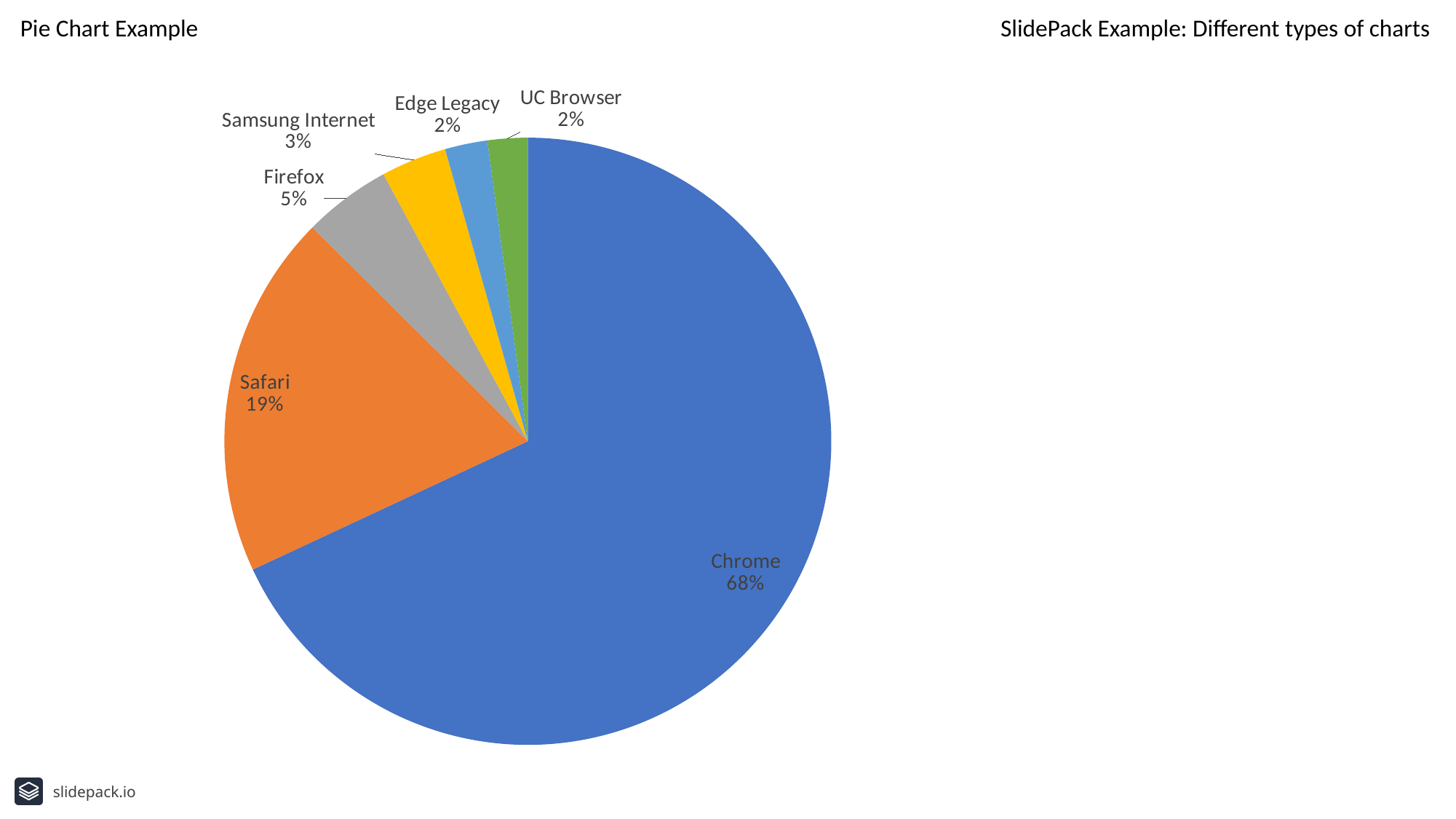
What is the difference between the Safari and Firefox shares? 14% What share of the pie does Safari have? 19% What is the value shown for Firefox? 5% Which browser has the largest slice of the pie? Chrome Which is larger, the Firefox slice or the Samsung Internet slice? Firefox What is the value shown for Edge Legacy? 2% How many slices does the pie chart have? 6 What colour is the Safari slice? orange What share of the pie does Chrome have? 68% What kind of chart is shown on the slide? pie chart What is the value shown for Samsung Internet? 3% What is the difference between the Chrome and Safari shares? 49%